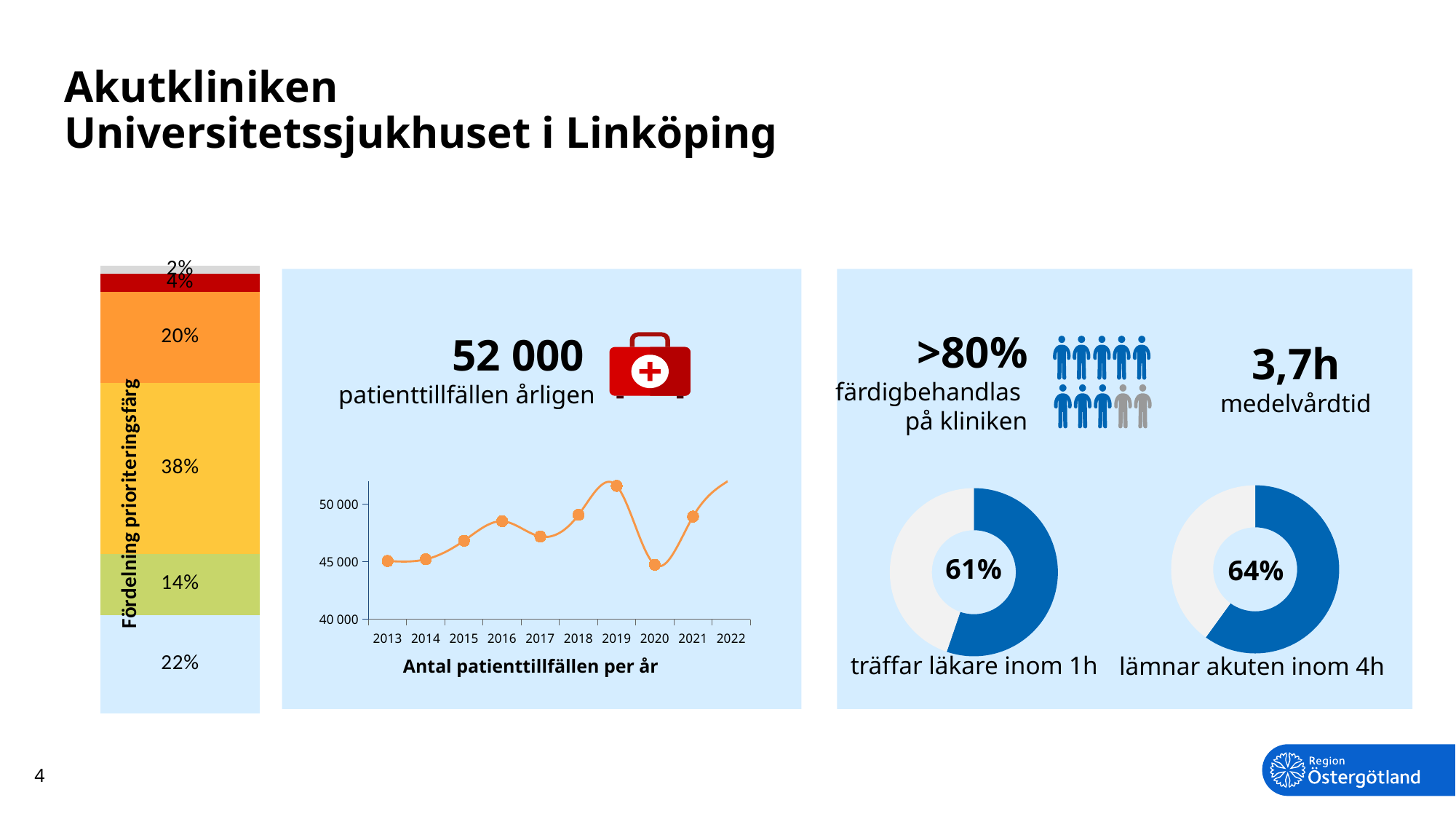
In the stacked bar 'Fördelning prioriteringsfärg', what colour is the 38% segment? Yellow Which donut chart shows the larger share, 'träffar läkare inom 1h' or 'lämnar akuten inom 4h'? lämnar akuten inom 4h What kind of chart is 'Antal patienttillfällen per år'? Line chart In the stacked bar 'Fördelning prioriteringsfärg', what is the value of the largest segment? 38% In the chart 'Antal patienttillfällen per år', is the value for 2020 greater or less than 50 000? less In the chart 'Antal patienttillfällen per år', is the value for 2019 greater or less than 50 000? greater How many years are shown on the x axis of the chart 'Antal patienttillfällen per år'? 10 How many segments does the stacked bar 'Fördelning prioriteringsfärg' contain? 6 In the chart 'Antal patienttillfällen per år', which year has the larger value, 2019 or 2020? 2019 In the stacked bar 'Fördelning prioriteringsfärg', what is the value of the smallest segment? 2% In the stacked bar 'Fördelning prioriteringsfärg', what is the difference between the 38% segment and the 14% segment? 24% In the chart 'Antal patienttillfällen per år', do the values rise or fall from 2019 to 2020? Fall